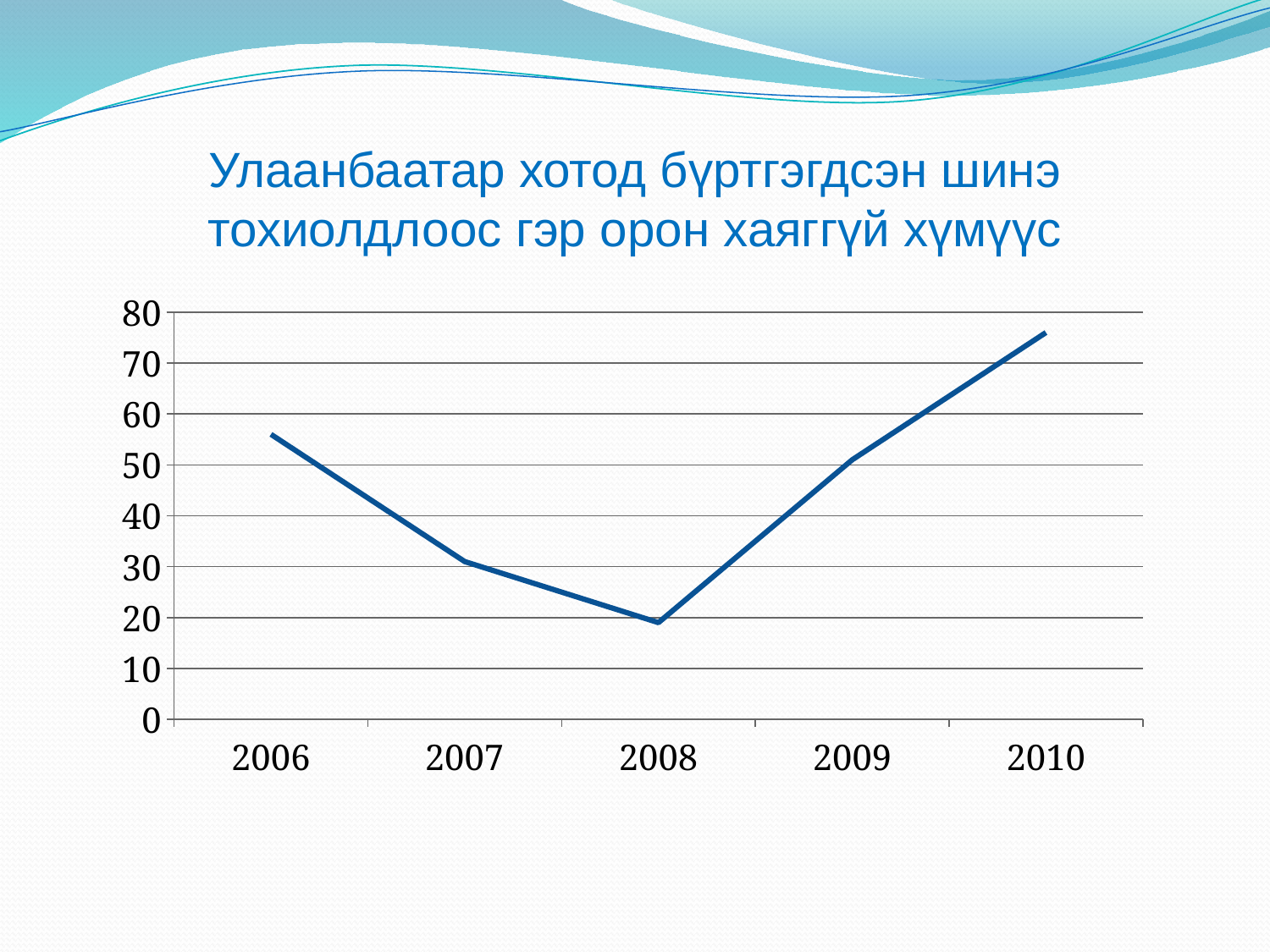
Is the value for 2007 greater or less than 40? less Which is larger, the value for 2009 or the value for 2008? 2009 What kind of chart is shown on the slide? line chart Is the value for 2010 greater or less than 70? greater Do the values rise or fall from 2008 to 2010? rise Do the values rise or fall from 2006 to 2008? fall Which is larger, the value for 2006 or the value for 2007? 2006 Which year has the highest value? 2010 Which year has the lowest value? 2008 How many years are plotted along the x axis? 5 Is the value for 2008 greater or less than 30? less